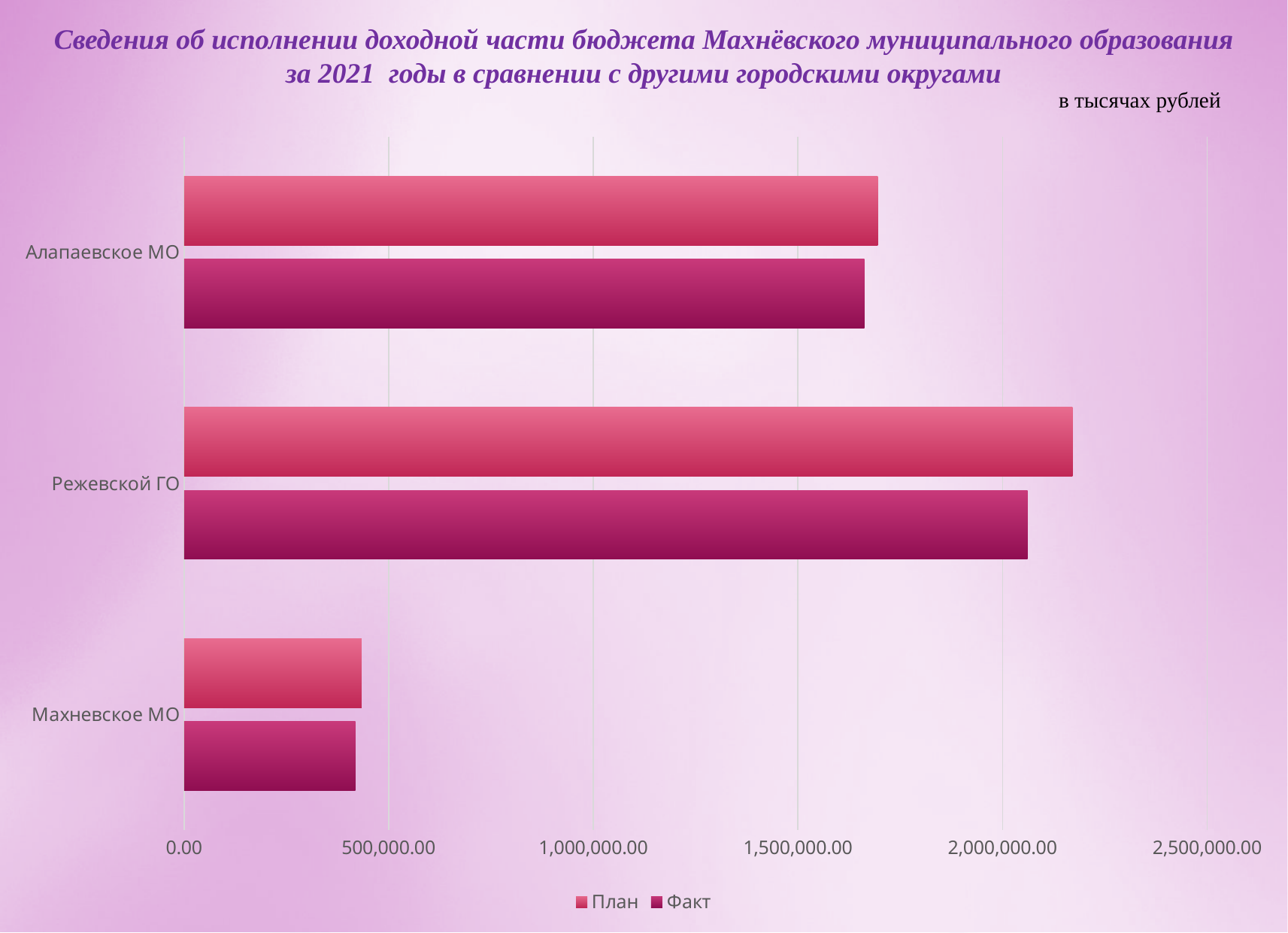
Which municipality has the highest План value? Режевской ГО How many series does the legend list? 2 Is the План value for Махневское МО greater or less than 500,000.00? less How many municipalities (categories) are shown on the chart? 3 Is the Факт value for Алапаевское МО greater or less than 1,500,000.00? greater Is the План value for Режевской ГО greater or less than 2,000,000.00? greater Which municipality has the lowest Факт value? Махневское МО For Режевской ГО, which is larger: the План value or the Факт value? План What are the two series named in the legend? План and Факт Which is larger: the План value for Режевской ГО or the План value for Алапаевское МО? Режевской ГО In what units are the values on the chart given, according to the note above the chart? в тысячах рублей What kind of chart is shown on the slide? bar chart